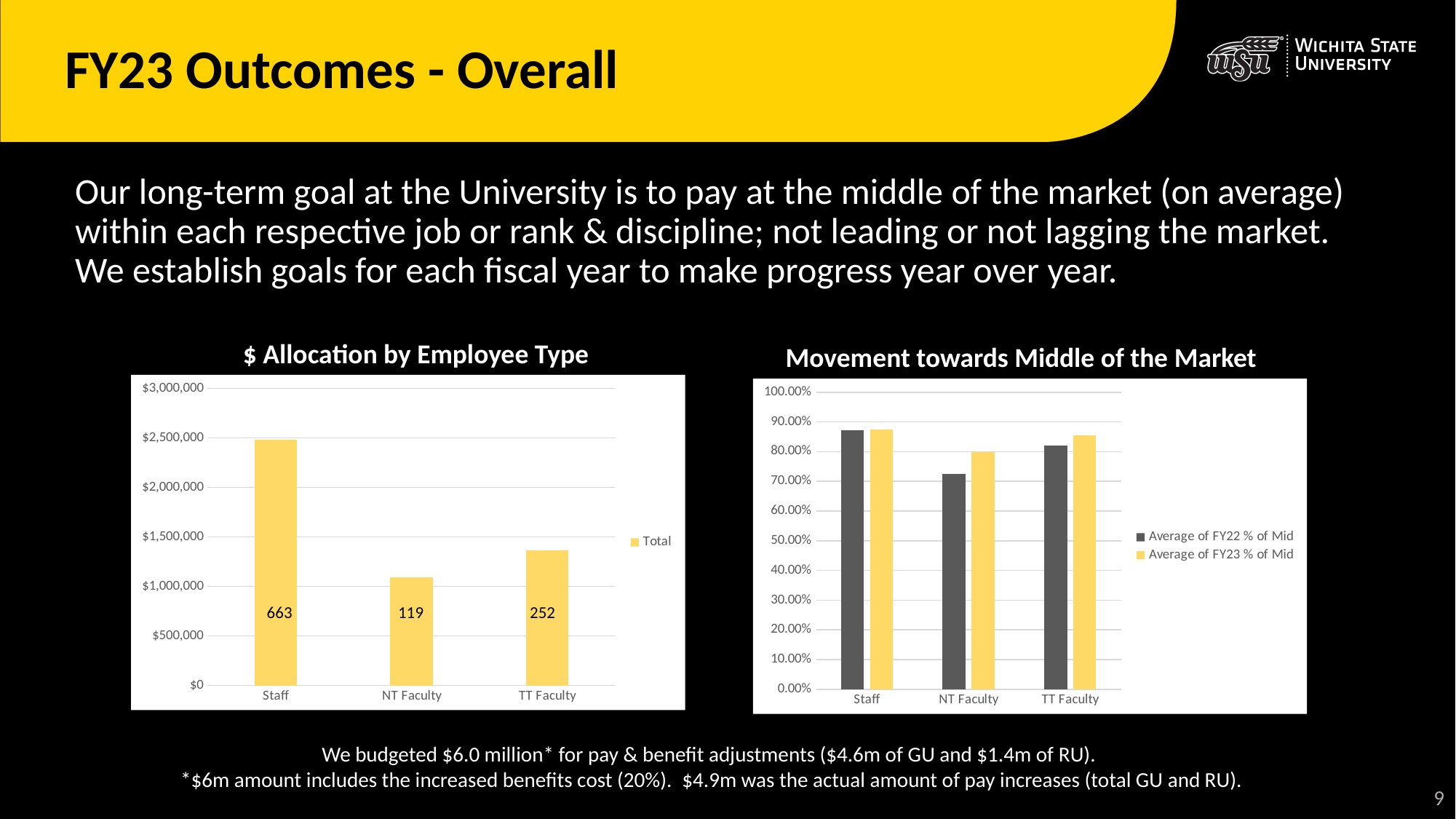
In the '$ Allocation by Employee Type' chart, is the allocation for Staff greater or less than $2,000,000? greater In the 'Movement towards Middle of the Market' chart, is the Average of FY22 % of Mid for NT Faculty greater or less than 80.00%? less In the '$ Allocation by Employee Type' chart, what number is printed on the Staff bar? 663 In the 'Movement towards Middle of the Market' chart, which employee type has the lowest Average of FY22 % of Mid? NT Faculty In the '$ Allocation by Employee Type' chart, what number is printed on the TT Faculty bar? 252 In the 'Movement towards Middle of the Market' chart, which series is shown in yellow? Average of FY23 % of Mid In the '$ Allocation by Employee Type' chart, which employee type has the lowest allocation? NT Faculty In the '$ Allocation by Employee Type' chart, is the allocation for NT Faculty greater or less than $1,500,000? less What kind of chart is the '$ Allocation by Employee Type' chart? bar chart How many series does the legend of the 'Movement towards Middle of the Market' chart list? 2 In the '$ Allocation by Employee Type' chart, which employee type has the highest allocation? Staff How many employee types are shown in the '$ Allocation by Employee Type' chart? 3